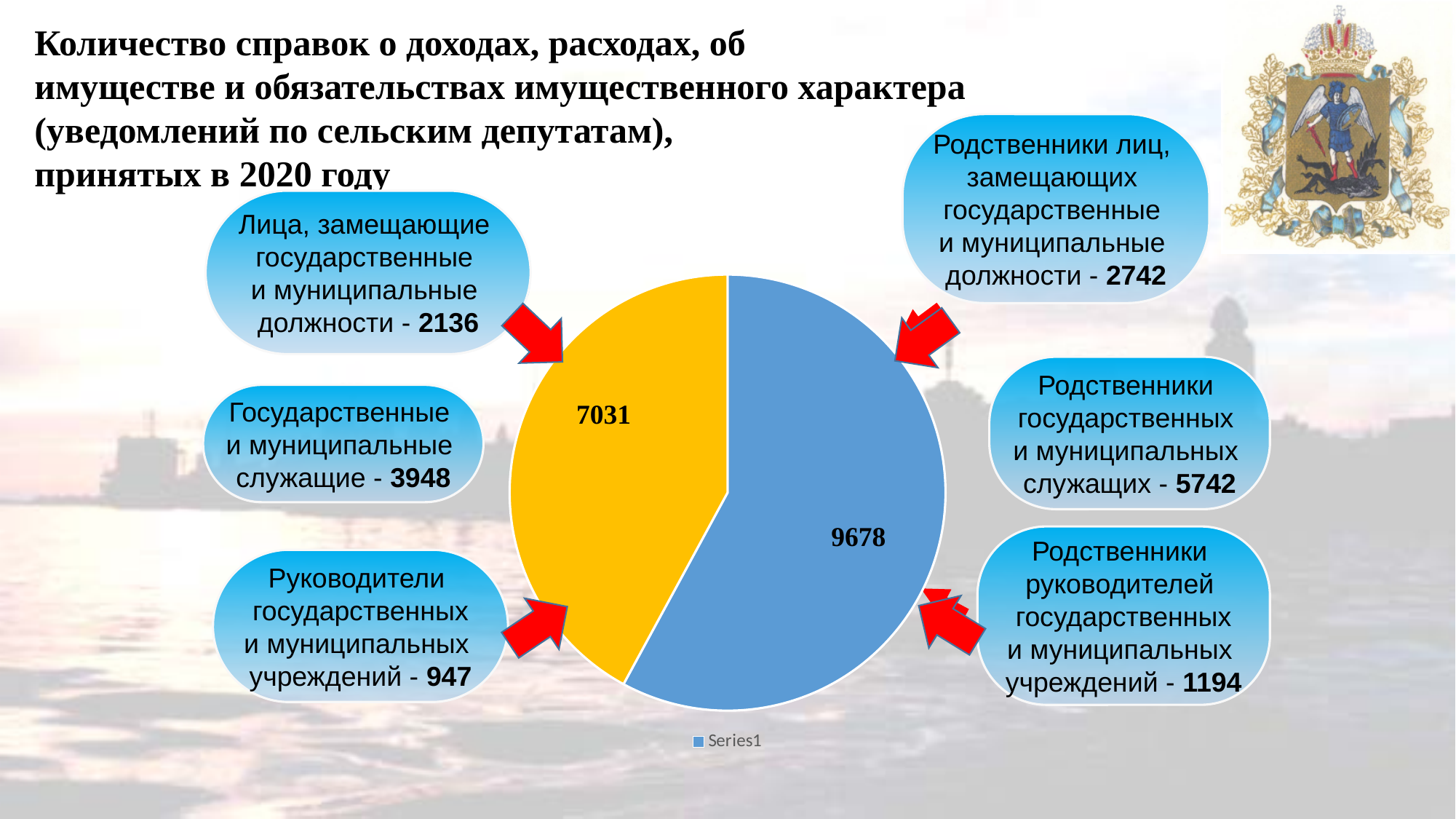
How many slices does the pie chart have? 2 What value is printed on the blue slice of the pie chart? 9678 Which slice of the pie chart is the smallest? the yellow slice (7031) What share of the pie does the blue slice (9678) represent? 57.9% What is the difference between the blue slice value and the yellow slice value? 2647 What is the total of the two slice values in the pie chart? 16709 What kind of chart is shown on the slide? pie chart What value is printed on the yellow slice of the pie chart? 7031 What entry does the legend below the pie chart show? Series1 Which slice of the pie chart is the largest? the blue slice (9678) Is the value of the yellow slice larger or smaller than the value of the blue slice? smaller According to the callout on the slide, how many certificates were submitted by 'Государственные и муниципальные служащие'? 3948